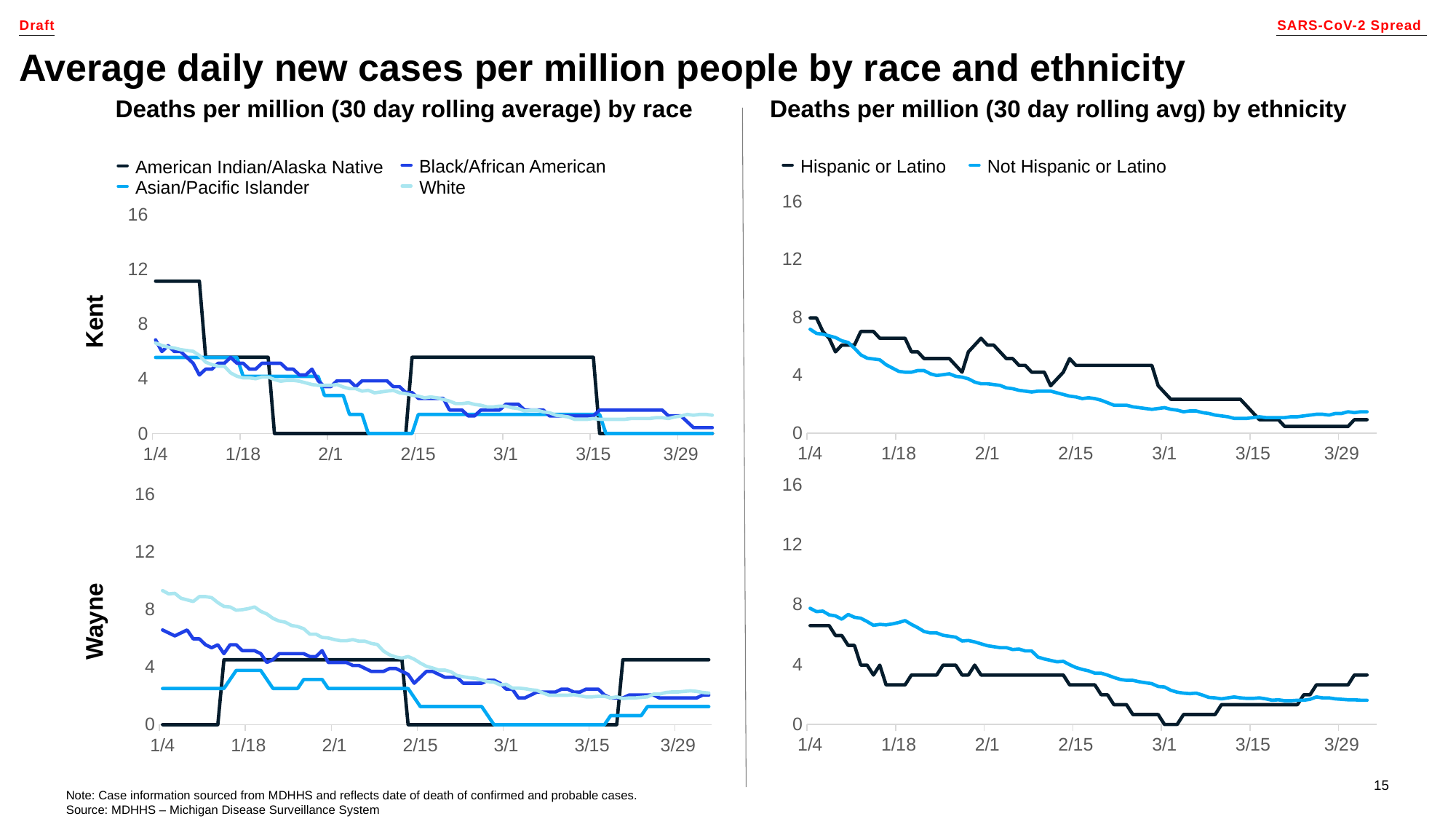
What kind of chart is the Kent 'Deaths per million (30 day rolling average) by race' chart? line chart How many date ticks are shown on the x axis of the Kent by race chart? 7 In the Wayne by ethnicity chart, which is larger on 1/18: Hispanic or Latino or Not Hispanic or Latino? Not Hispanic or Latino In the Wayne by ethnicity chart, is the value for Hispanic or Latino around 3/1 greater or less than 4? less In the Kent by race chart, is the value for American Indian/Alaska Native on 1/4 greater or less than 8? greater In the Wayne by race chart, which series has the highest value on 1/4? White In the Wayne by ethnicity chart, does the Not Hispanic or Latino line rise or fall from 1/4 to 3/29? fall How many series does the legend list for the 'Deaths per million (30 day rolling avg) by ethnicity' charts? 2 In the Kent by ethnicity chart, does the Not Hispanic or Latino line rise or fall from 1/4 to 3/29? fall What is the title of the left-hand pair of charts? Deaths per million (30 day rolling average) by race In the Wayne by race chart, is the value for White on 1/4 greater or less than 8? greater How many series does the legend list for the 'Deaths per million (30 day rolling average) by race' charts? 4